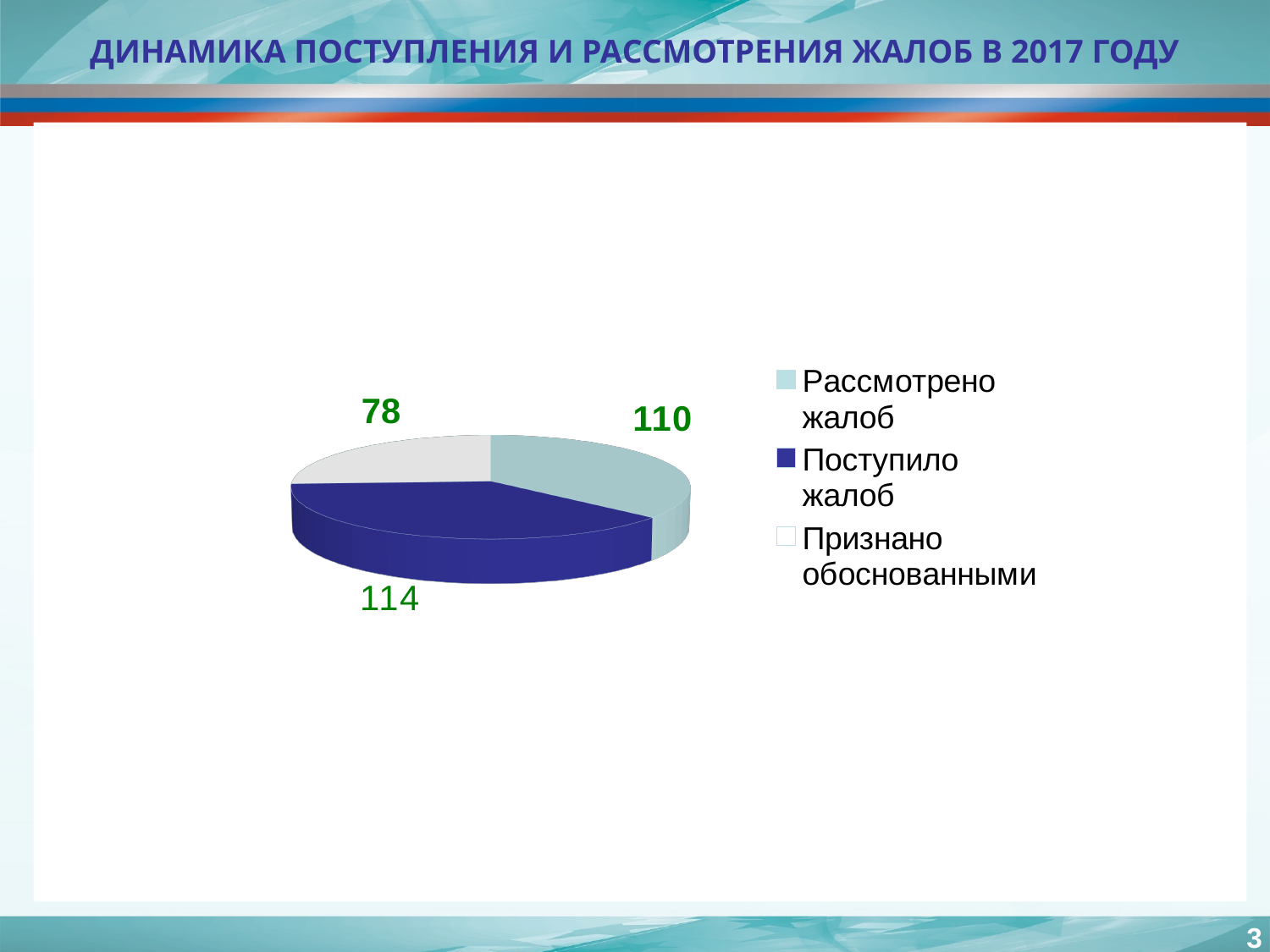
What type of chart is shown on the slide? pie chart Which category has the smallest slice of the pie? Признано обоснованными What is the value for Признано обоснованными? 78 What is the value for Поступило жалоб? 114 What is the difference between Рассмотрено жалоб and Признано обоснованными? 32 How many entries does the legend list? 3 Which is larger, Рассмотрено жалоб or Признано обоснованными? Рассмотрено жалоб What is the difference between Поступило жалоб and Рассмотрено жалоб? 4 How many slices does the pie chart have? 3 Which category has the largest slice of the pie? Поступило жалоб What is the title of the slide containing the chart? ДИНАМИКА ПОСТУПЛЕНИЯ И РАССМОТРЕНИЯ ЖАЛОБ В 2017 ГОДУ What is the value for Рассмотрено жалоб? 110